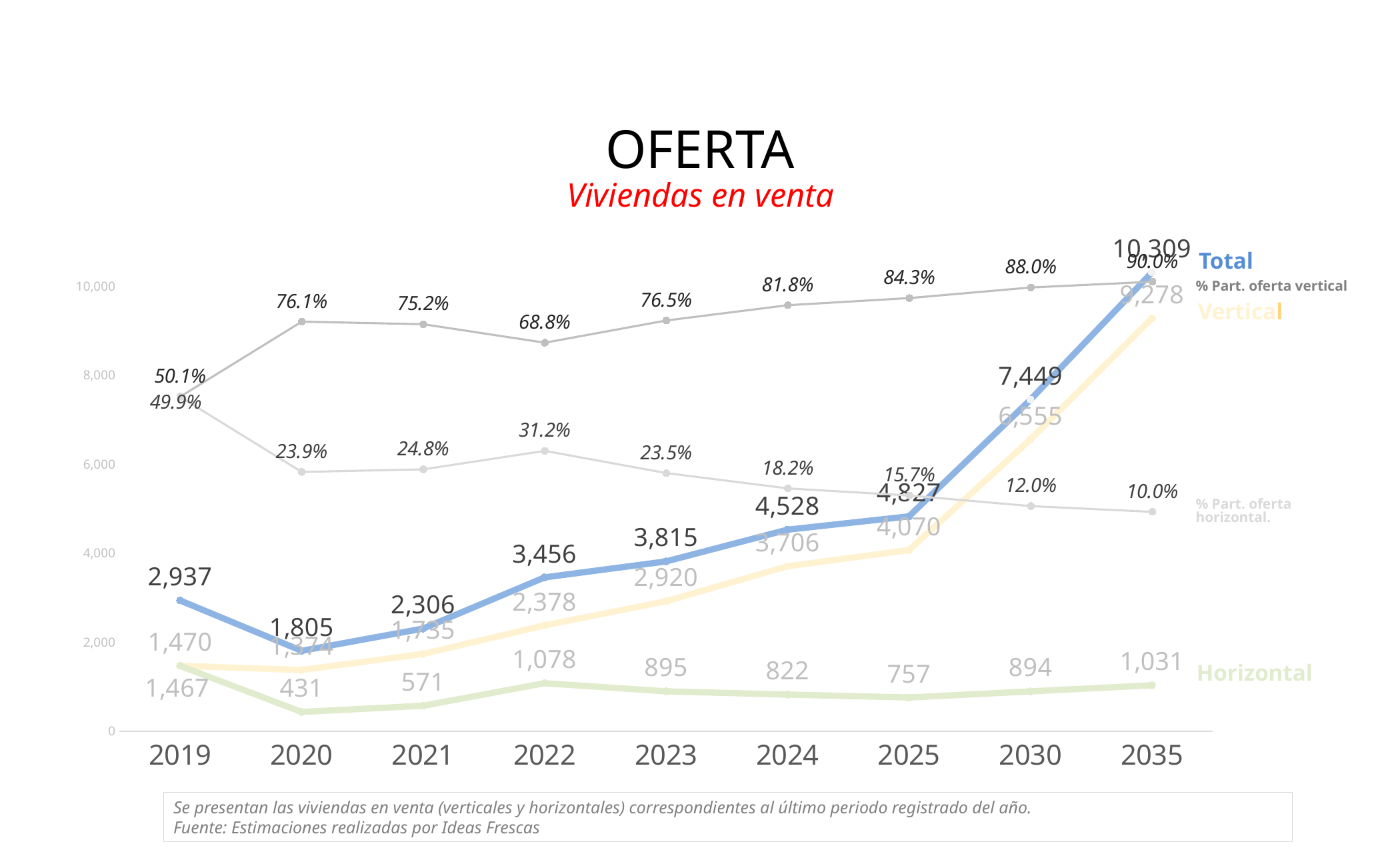
What is the Horizontal value for 2020? 431 What is the % Part. oferta horizontal value for 2030? 12.0% What is the difference between the Total values for 2035 and 2030? 2,860 What is the Total value for 2035? 10,309 In which year is the Total series at its lowest? 2020 What is the % Part. oferta vertical value for 2022? 68.8% What is the Vertical value for 2024? 3,706 In which year is the Horizontal series at its highest? 2019 How many years are shown on the x axis? 9 Does the % Part. oferta horizontal series rise or fall from 2022 to 2035? Fall What kind of chart is shown on the slide? Line chart Which is larger, the Vertical value for 2019 or the Horizontal value for 2019? Vertical (1,470)